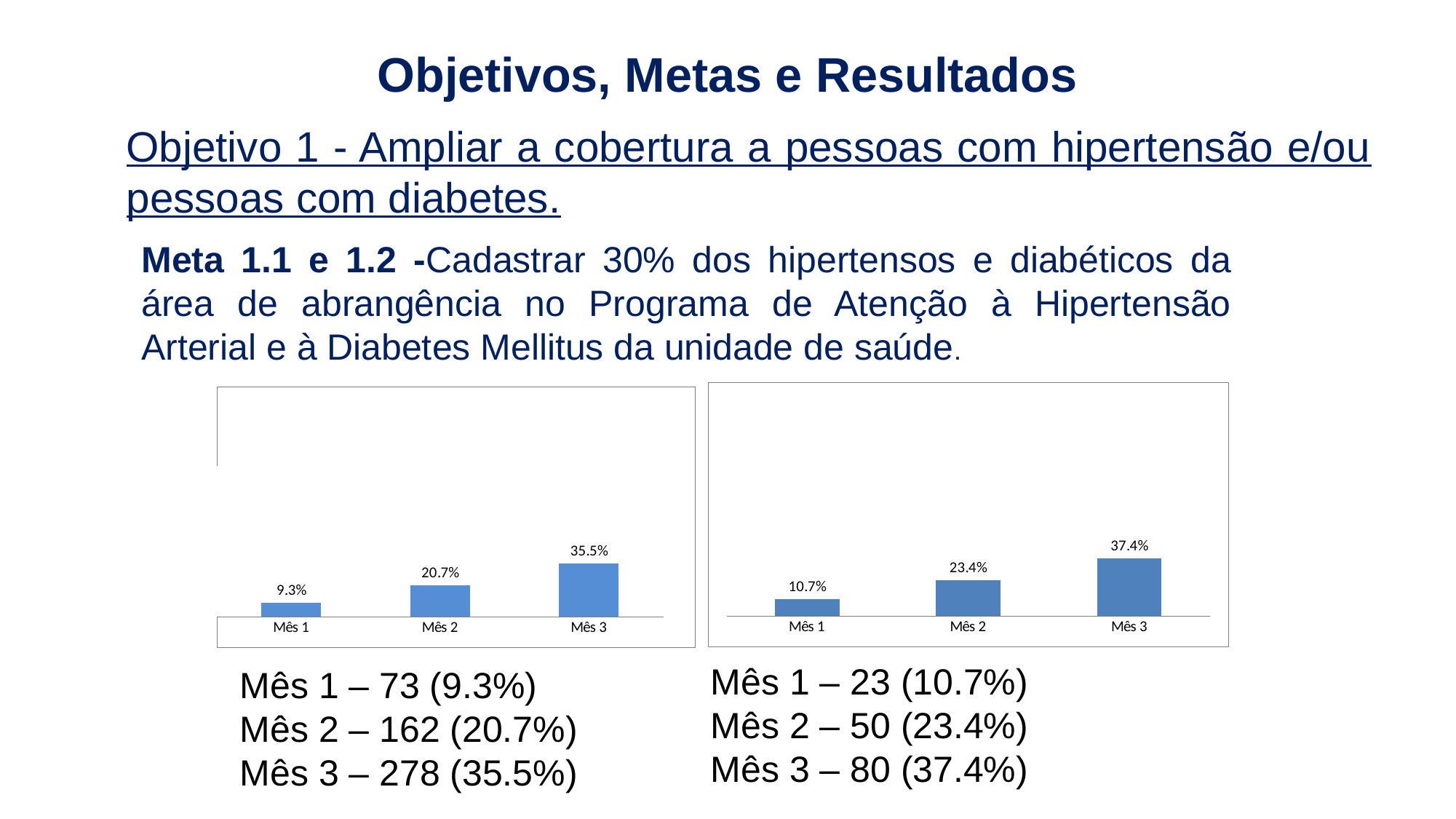
How many bars does the left chart have? 3 In the right chart, what is the difference between the values for Mês 2 and Mês 1? 12.7% Which is larger: the value for Mês 3 in the left chart or the value for Mês 3 in the right chart? Mês 3 in the right chart In the right chart, do the values rise or fall from Mês 1 to Mês 3? Rise In the right chart, what is the value for Mês 3? 37.4% In the left chart, which month has the highest value? Mês 3 In the right chart, which month has the lowest value? Mês 1 In the right chart, what is the value for Mês 1? 10.7% In the left chart, what is the value for Mês 1? 9.3% What kind of chart is the right chart? Bar chart In the left chart, what is the difference between the values for Mês 3 and Mês 1? 26.2% In the left chart, what is the value for Mês 2? 20.7%